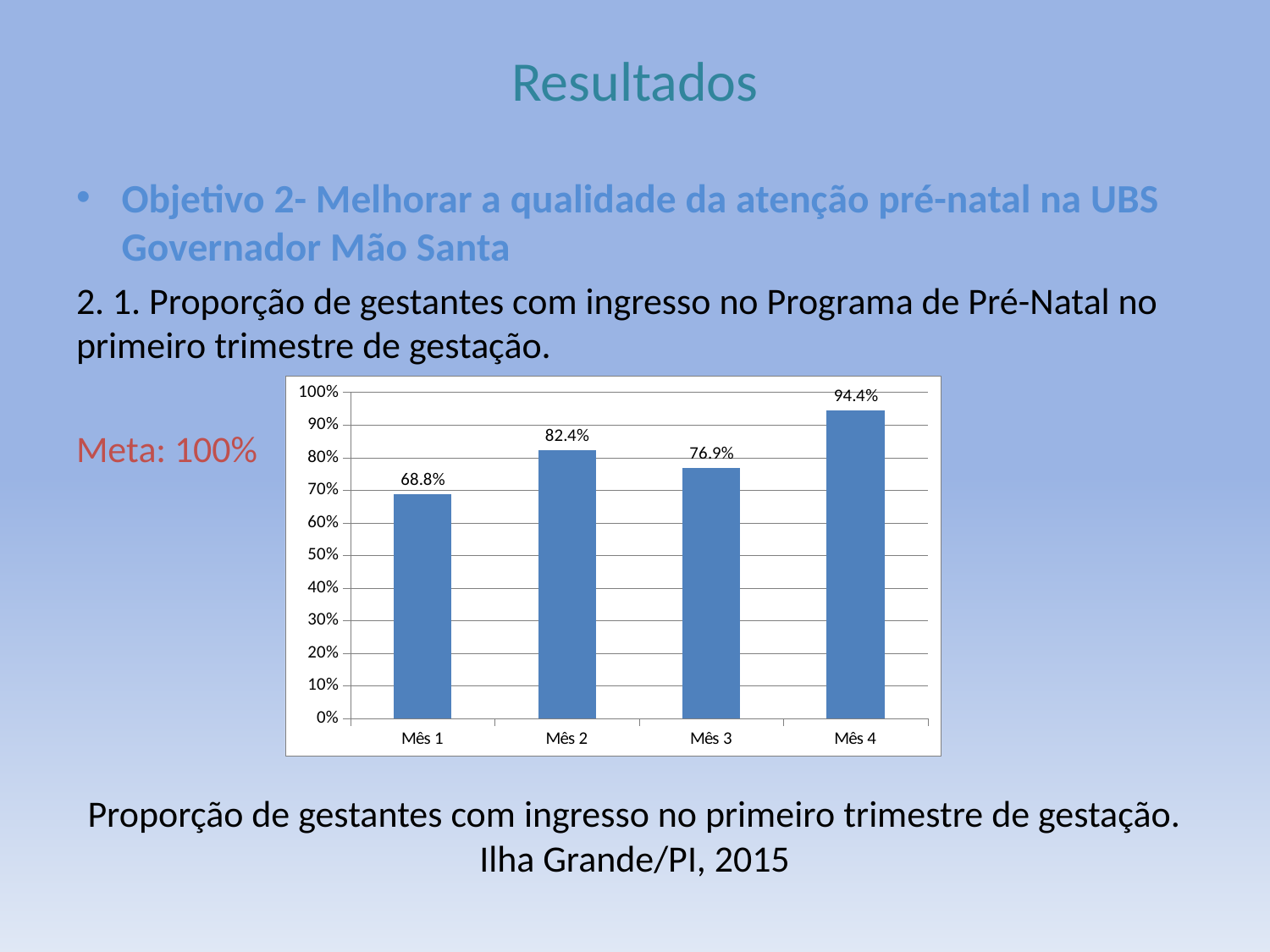
What is the value for Mês 2? 82.4% What kind of chart is shown on the slide? bar chart Which month has the highest value? Mês 4 How many months are shown on the x axis? 4 Which is larger, the value for Mês 2 or the value for Mês 3? Mês 2 What is the value for Mês 1? 68.8% Which month has the lowest value? Mês 1 What is the value for Mês 4? 94.4% What is the target (Meta) stated next to the chart? 100% Is the value for Mês 4 greater or less than 90%? greater What is the difference between the values for Mês 4 and Mês 1? 25.6% What is the value for Mês 3? 76.9%